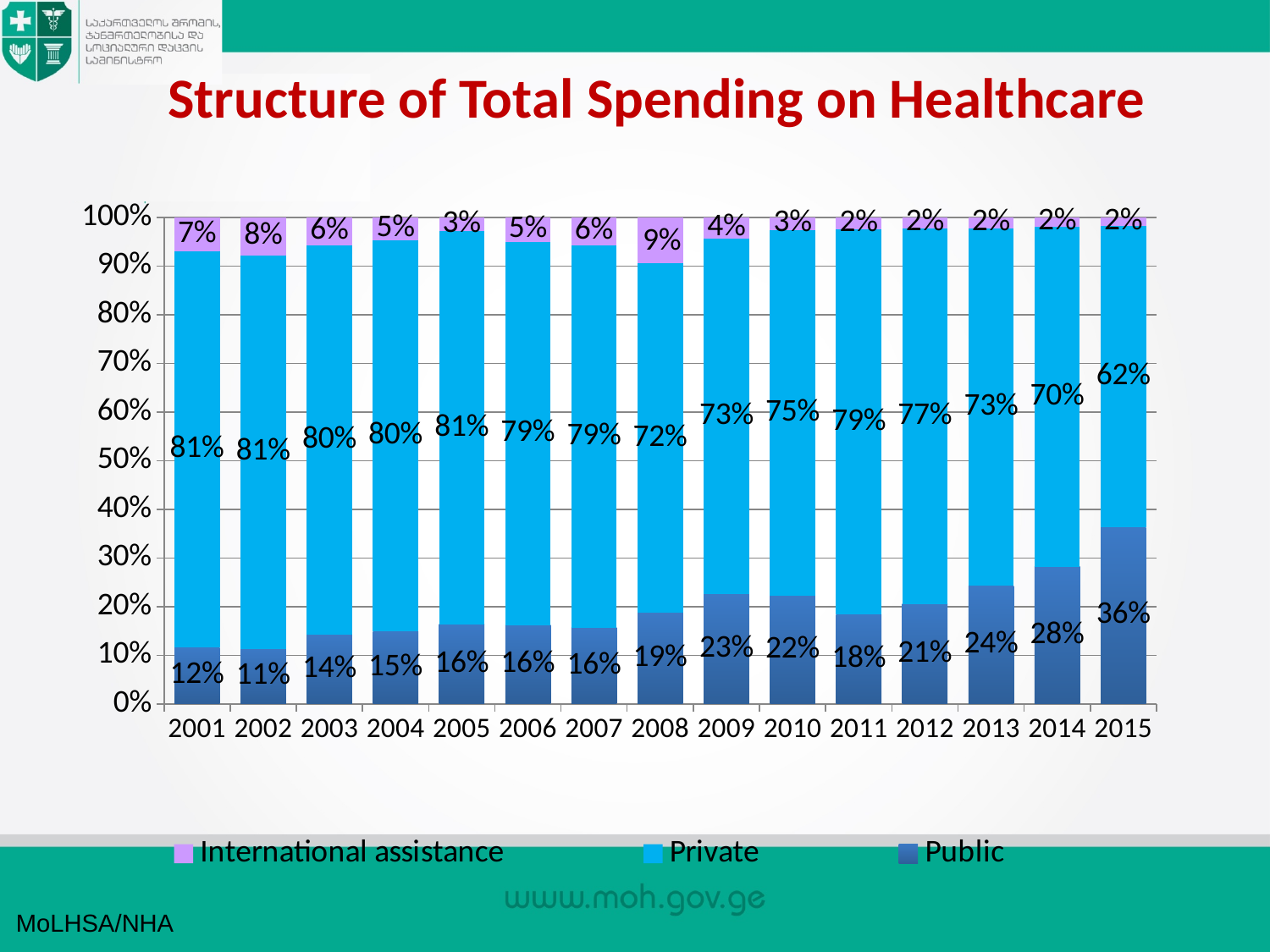
What is the International assistance share in 2002? 8% What is the difference between the Public share in 2015 and the Public share in 2001? 24% Does the Public share of spending generally rise or fall from 2001 to 2015? Rise How many years are shown on the x axis? 15 How many series does the legend list? 3 In which year is the Public share of spending highest? 2015 What is the title of the chart? Structure of Total Spending on Healthcare What kind of chart is shown on the slide? Stacked bar chart What is the Public share of total healthcare spending in 2015? 36% Which is larger, the International assistance share in 2008 or in 2009? 2008 In which year is the Private share of spending lowest? 2015 What is the Private share of total healthcare spending in 2008? 72%